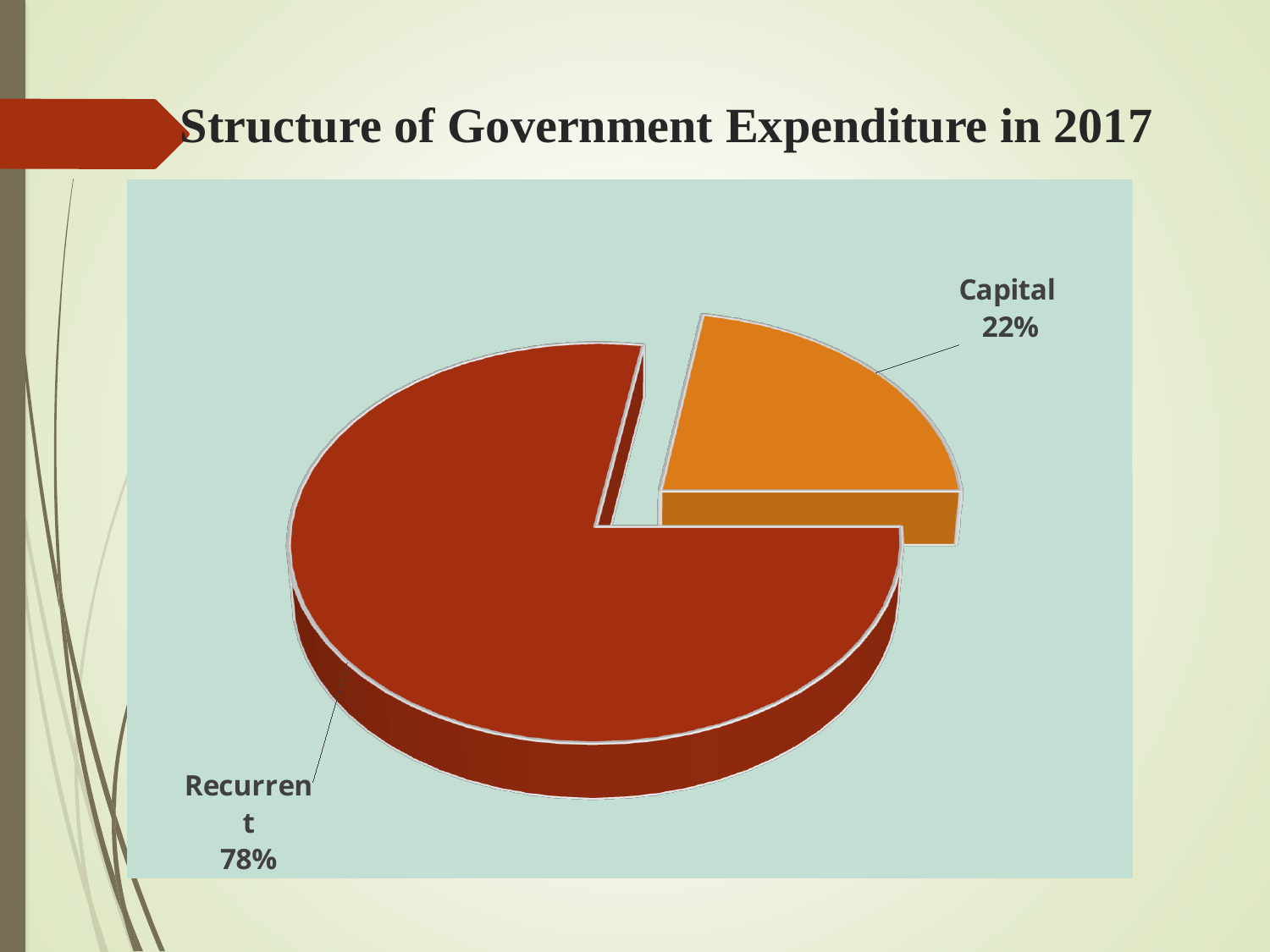
What kind of chart is shown on the slide? Pie chart Which category has the largest share of the pie? Recurrent What is the title of the slide? Structure of Government Expenditure in 2017 What colour is the Capital slice? Orange What share of government expenditure in 2017 is Recurrent? 78% How many slices does the pie chart have? 2 What share of government expenditure in 2017 is Capital? 22% Which is larger, the Capital share or the Recurrent share? Recurrent Which category has the smallest share of the pie? Capital What is the difference in percentage points between the Recurrent and Capital shares? 56